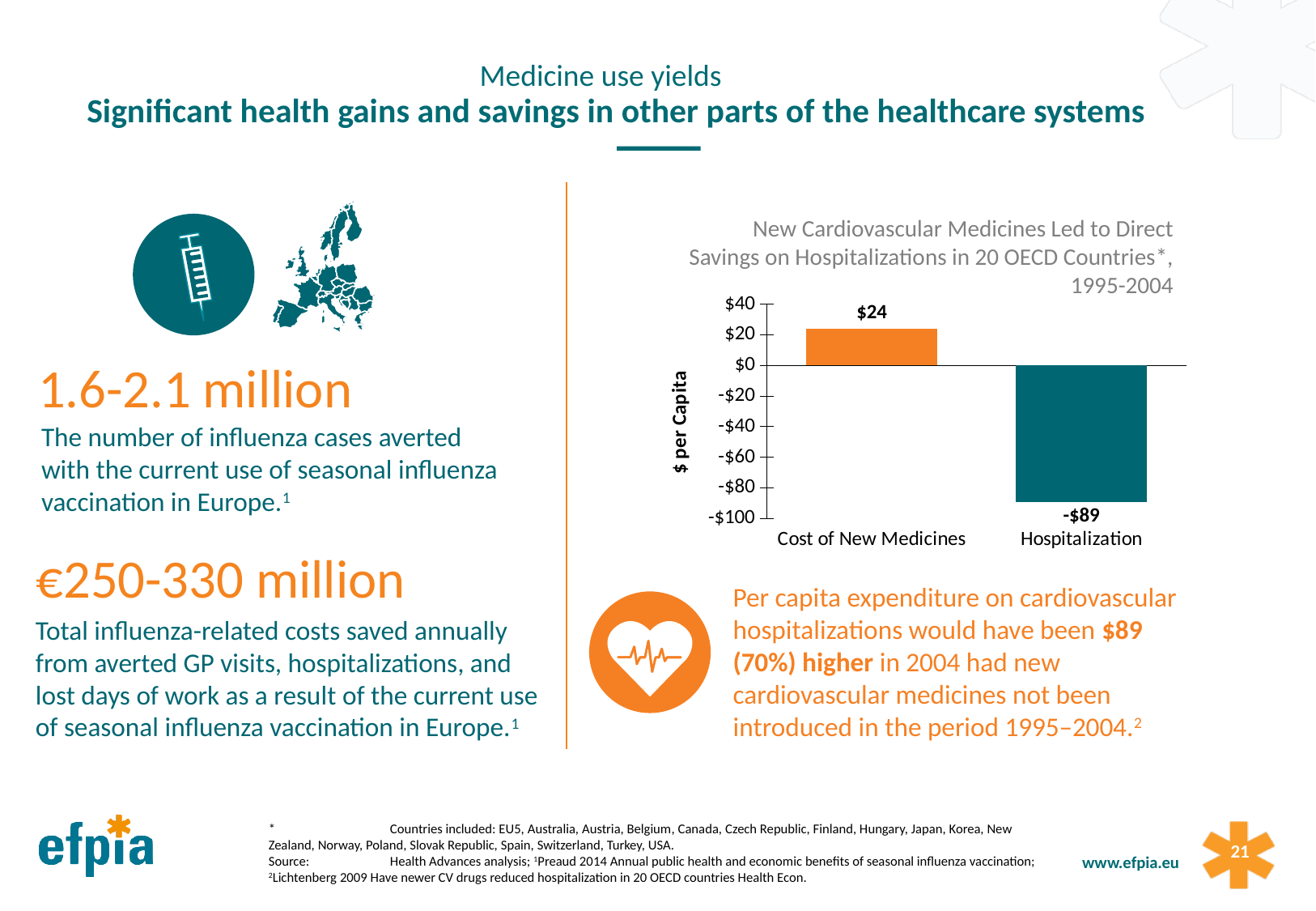
Is the value for Hospitalization greater or less than -$60? less Which category has the highest value? Cost of New Medicines What is the difference between the value for Cost of New Medicines and the value for Hospitalization? $113 What is the value for Hospitalization? -$89 Is the value for Cost of New Medicines greater or less than $20? greater What is the label of the vertical axis of the chart? $ per Capita How many categories are shown on the x axis of the chart? 2 Which is larger, the value for Cost of New Medicines or the value for Hospitalization? Cost of New Medicines What colour is the Hospitalization bar? Teal Which category has the lowest value? Hospitalization What is the value for Cost of New Medicines? $24 What kind of chart is shown on the slide? Bar chart